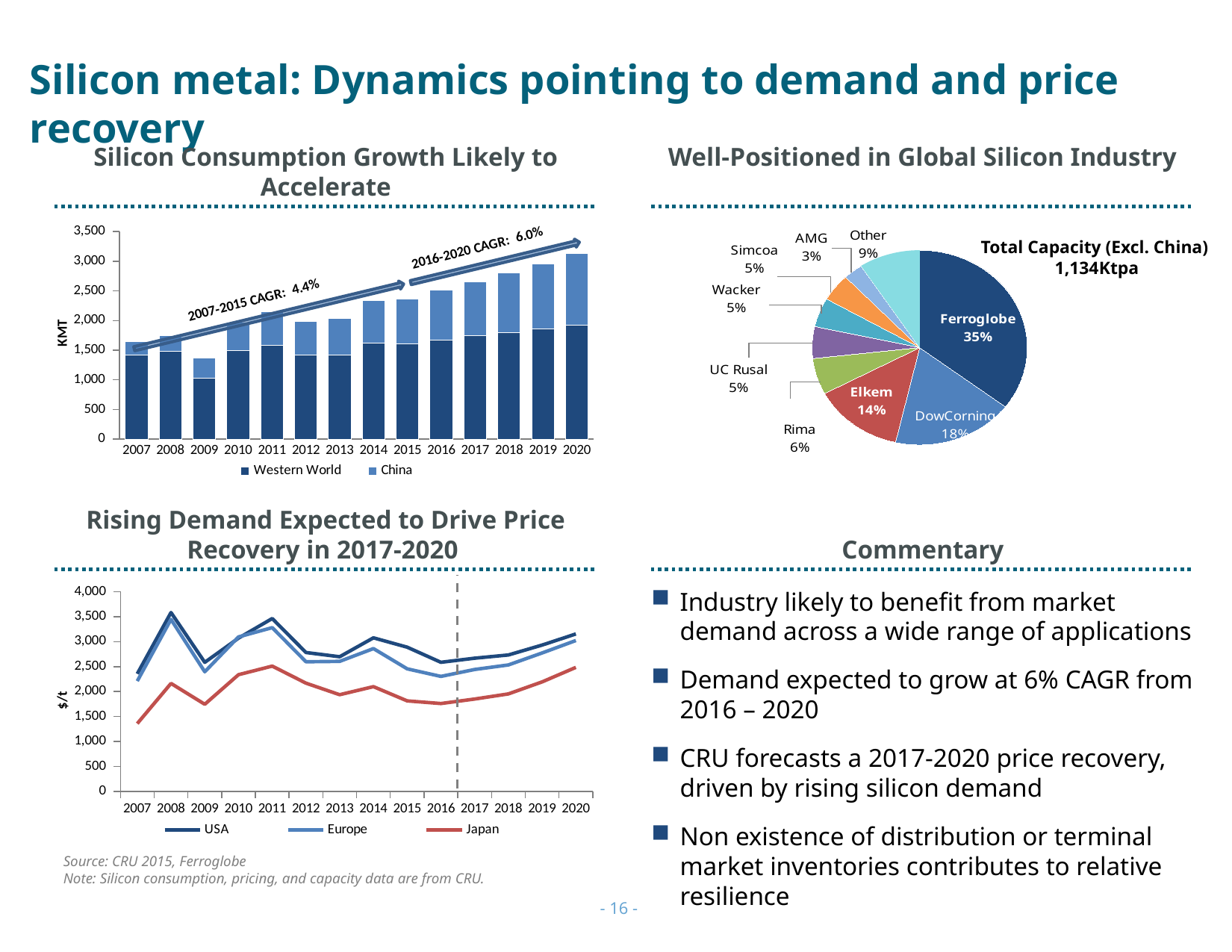
In the 'Well-Positioned in Global Silicon Industry' pie chart, what share does DowCorning hold? 18% In the 'Well-Positioned in Global Silicon Industry' pie chart, what total capacity (excl. China) is stated? 1,134Ktpa In the 'Well-Positioned in Global Silicon Industry' pie chart, which company has the largest share? Ferroglobe In the 'Silicon Consumption Growth Likely to Accelerate' chart, is the total value for 2009 greater or less than 1,500? less In the 'Well-Positioned in Global Silicon Industry' pie chart, what share does Ferroglobe hold? 35% In the 'Silicon Consumption Growth Likely to Accelerate' chart, what is the 2016-2020 CAGR shown? 6.0% In the 'Well-Positioned in Global Silicon Industry' pie chart, what is the difference in percentage points between Ferroglobe's and Elkem's shares? 21 percentage points In the 'Rising Demand Expected to Drive Price Recovery in 2017-2020' chart, is the value for Japan in 2016 greater or less than 2,000? less What type of chart is 'Silicon Consumption Growth Likely to Accelerate'? Stacked bar chart How many series does the legend of the 'Silicon Consumption Growth Likely to Accelerate' chart list? 2 In the 'Well-Positioned in Global Silicon Industry' pie chart, which named company has the smallest share? AMG How many series does the legend of the 'Rising Demand Expected to Drive Price Recovery in 2017-2020' chart list? 3